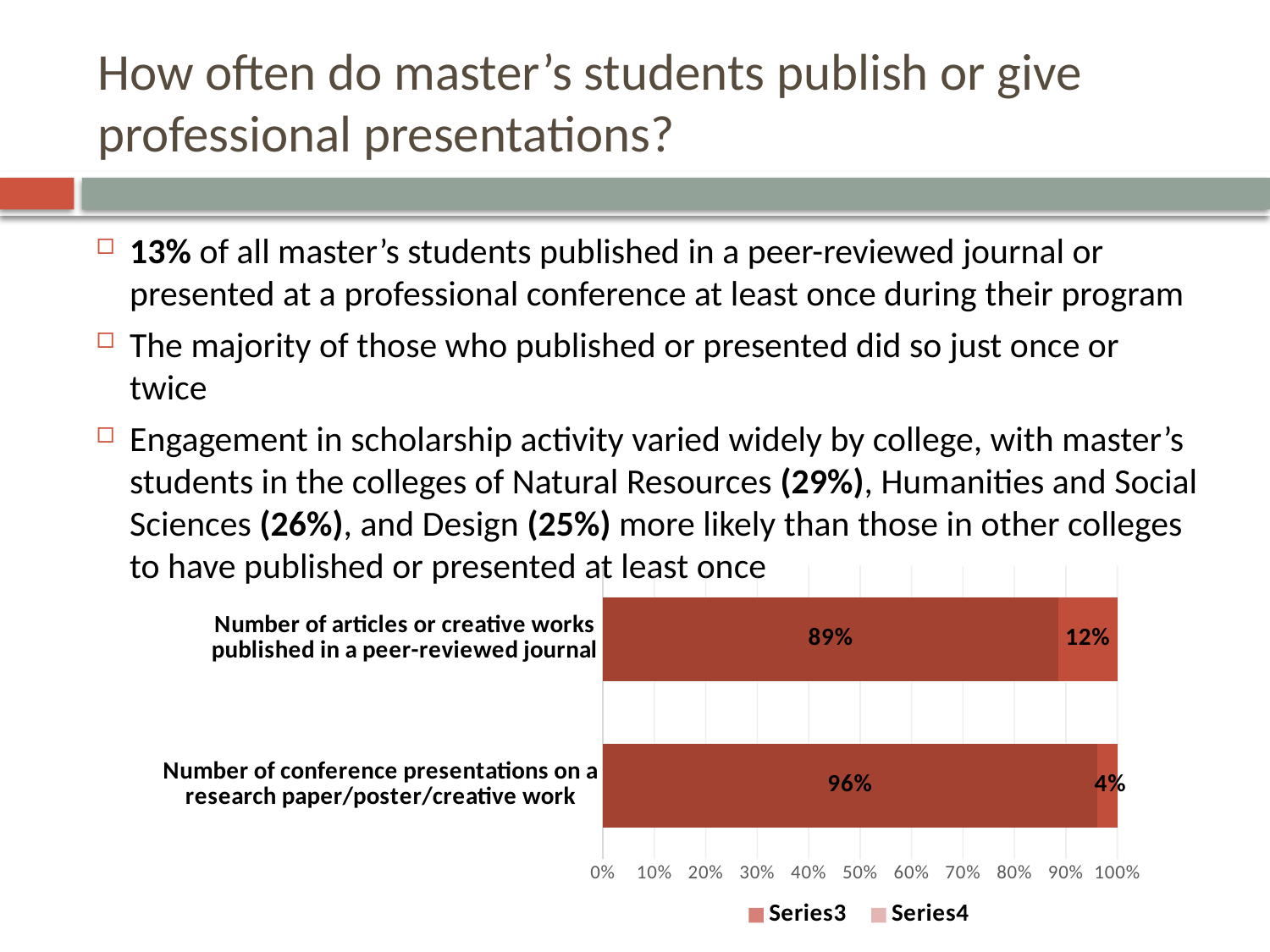
How many categories does the chart show? 2 Which category has the lower Series4 value? Number of conference presentations on a research paper/poster/creative work What is the Series3 value for 'Number of conference presentations on a research paper/poster/creative work'? 96% What is the Series4 value for 'Number of conference presentations on a research paper/poster/creative work'? 4% Is the Series4 value larger for articles published in a peer-reviewed journal or for conference presentations? Articles published in a peer-reviewed journal What is the difference between the Series3 values for conference presentations and for articles published in a peer-reviewed journal? 7% How many series does the chart legend list? 2 What is the Series4 value for 'Number of articles or creative works published in a peer-reviewed journal'? 12% What kind of chart is shown on the slide? Stacked bar chart What are the two series names listed in the chart legend? Series3 and Series4 What is the Series3 value for 'Number of articles or creative works published in a peer-reviewed journal'? 89% Which category has the higher Series3 value? Number of conference presentations on a research paper/poster/creative work